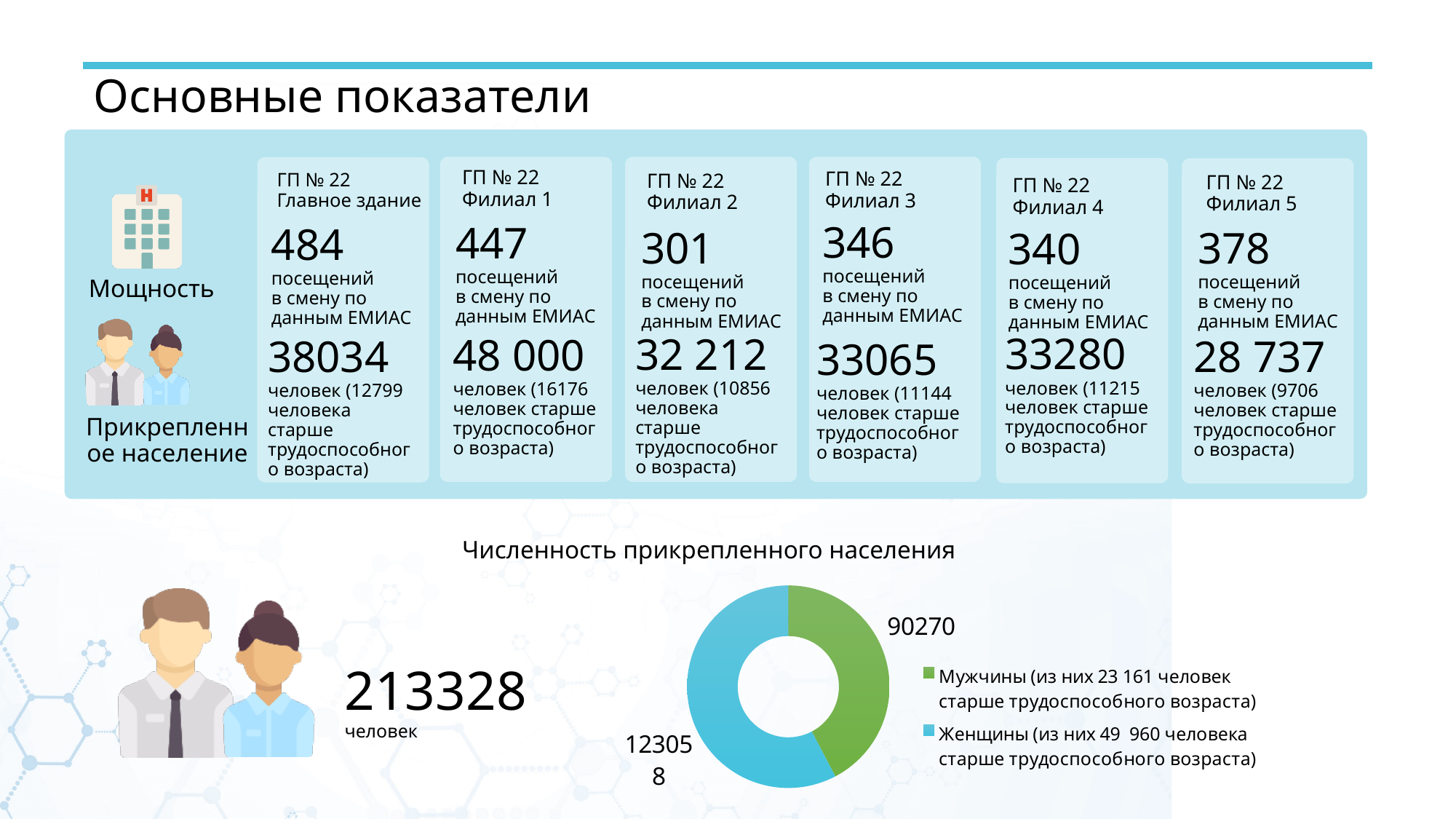
What kind of chart is shown under the title "Численность прикрепленного населения"? donut (pie) chart In the chart "Численность прикрепленного населения", what colour is the Мужчины slice? green In the chart "Численность прикрепленного населения", what is the difference between the values for Женщины and Мужчины? 32788 What is the title of the donut chart at the bottom of the slide? Численность прикрепленного населения How many entries does the legend of the chart "Численность прикрепленного населения" list? 2 In the chart "Численность прикрепленного населения", what is the value for Женщины? 123058 How many slices does the chart "Численность прикрепленного населения" have? 2 What is the total of the two slices in the chart "Численность прикрепленного населения"? 213328 In the chart "Численность прикрепленного населения", which category has the largest slice? Женщины In the chart "Численность прикрепленного населения", what is the value for Мужчины? 90270 In the chart "Численность прикрепленного населения", which is larger: Мужчины or Женщины? Женщины In the chart "Численность прикрепленного населения", which category has the smallest slice? Мужчины